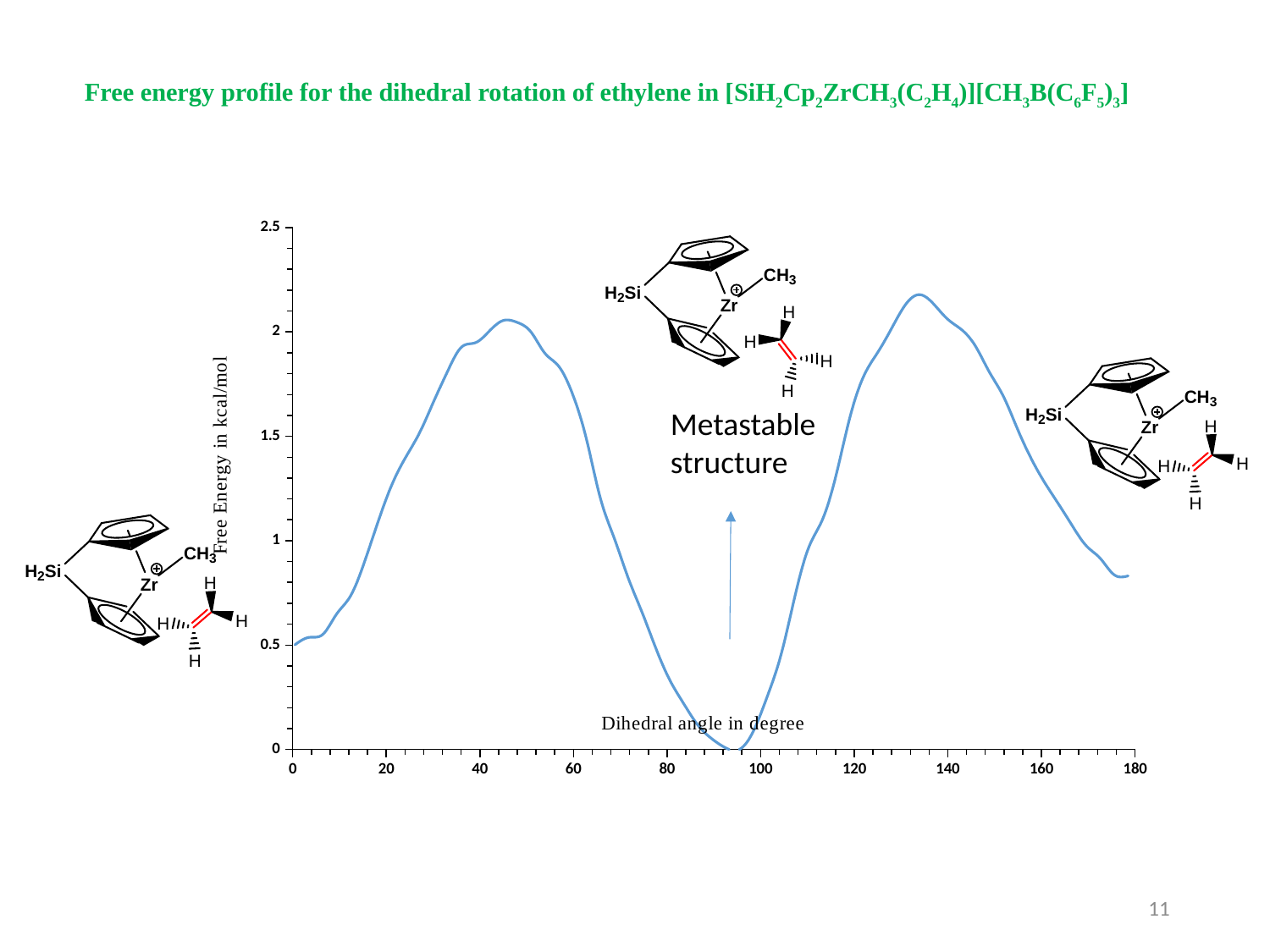
Does the free energy rise or fall as the dihedral angle increases from 0 to 40 degrees? rise What kind of chart is shown on the slide? line chart Is the free energy at a dihedral angle of 0 degrees greater or less than 1? less Does the free energy rise or fall as the dihedral angle increases from 60 to 90 degrees? fall Is the free energy at a dihedral angle of 180 degrees greater or less than 1? less Is the free energy at a dihedral angle of 100 degrees greater or less than 0.5? less What is the title of the x axis of the chart? Dihedral angle in degree What is the title of the y axis of the chart? Free Energy in kcal/mol